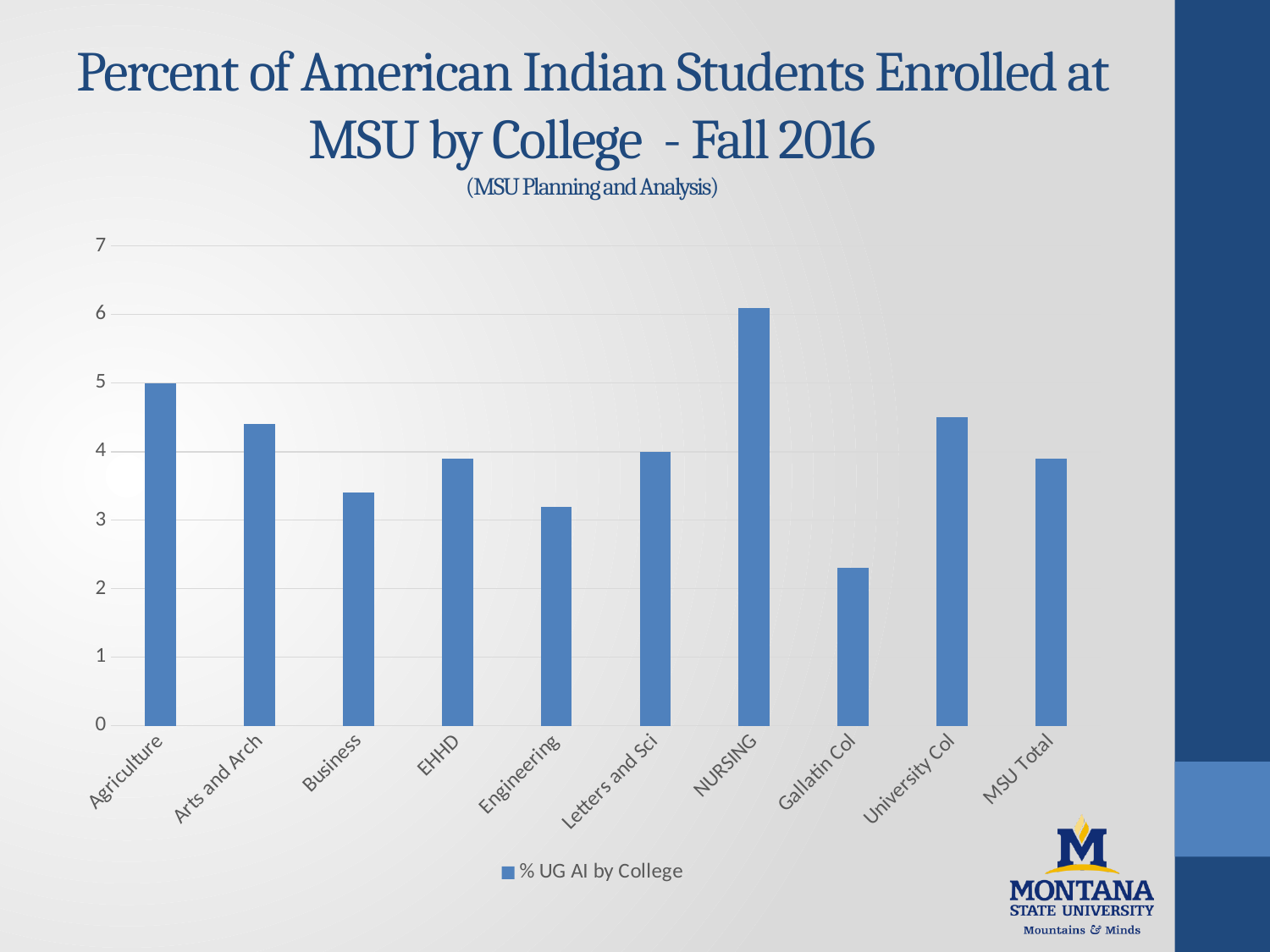
How many categories are shown on the x axis of the chart? 10 What kind of chart is shown on the slide? bar chart Which college has the lowest percent of American Indian students enrolled? Gallatin Col Which is larger, the value for Agriculture or the value for Engineering? Agriculture What is the value for Agriculture? 5 Which college has the highest percent of American Indian students enrolled? NURSING What is the series name shown in the legend? % UG AI by College Is the value for Gallatin Col greater or less than 3? less How many series does the legend list? 1 Is the value for NURSING greater or less than 5? greater Is the value for Business greater or less than 4? less What is the value for Letters and Sci? 4